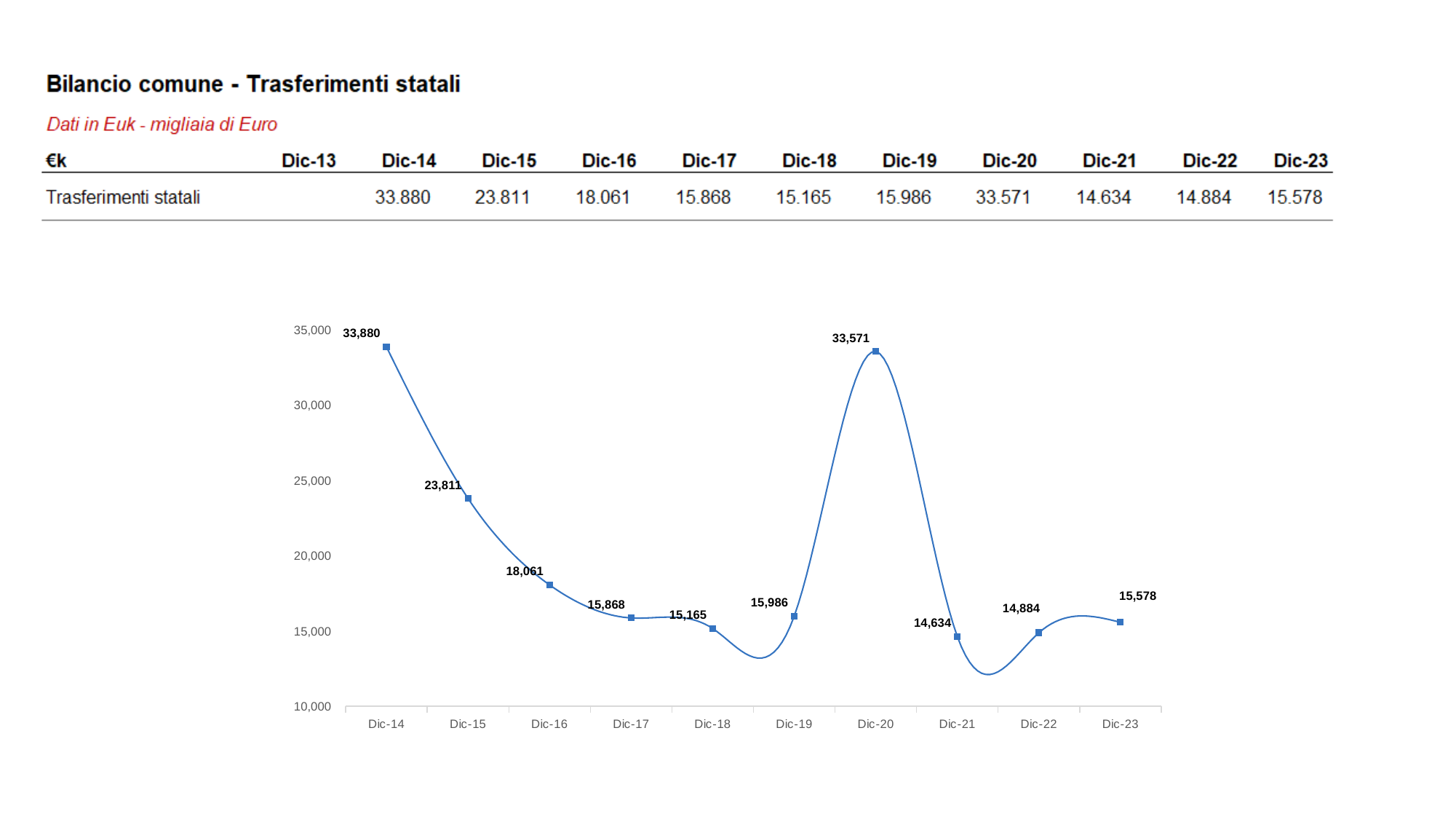
Is the value for Dic-15 greater or less than 20,000? greater What is the difference between the values for Dic-14 and Dic-15? 10,069 What kind of chart is shown on the slide? line chart What is the value plotted for Dic-18? 15,165 What is the value plotted for Dic-20? 33,571 Do the values rise or fall from Dic-14 to Dic-18? fall Which period has the lowest value on the chart? Dic-21 What is the value plotted for Dic-23? 15,578 How many data points are plotted on the chart? 10 What is the difference between the values for Dic-20 and Dic-21? 18,937 Which is larger, the value for Dic-16 or the value for Dic-19? Dic-16 Which period has the highest value on the chart? Dic-14